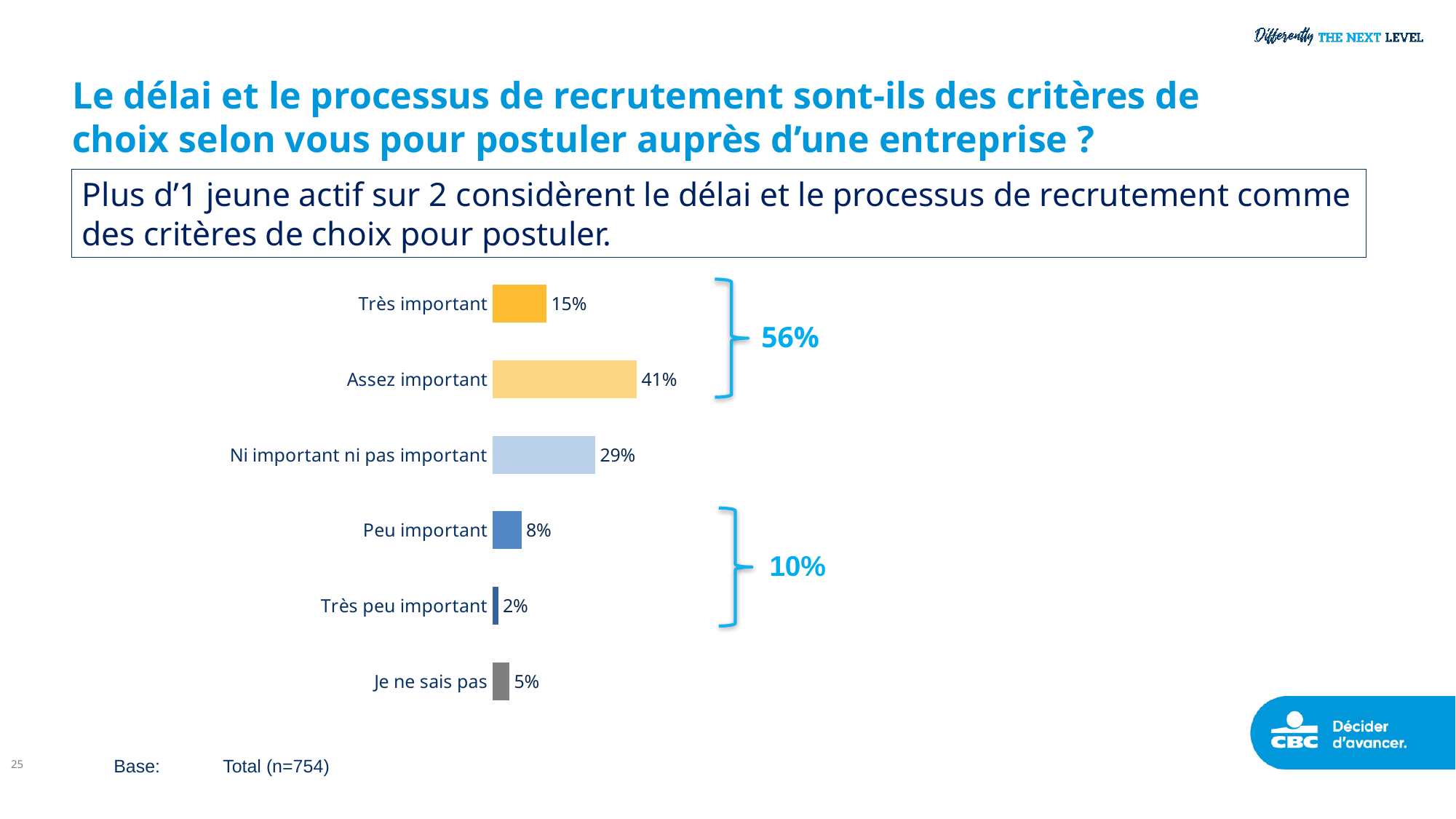
What is the value for "Très important"? 15% What is the difference between "Assez important" and "Très important"? 26% What combined percentage is shown by the bracket grouping "Très important" and "Assez important"? 56% Which category has the highest value? Assez important Which is larger, "Peu important" or "Je ne sais pas"? Peu important Which category has the lowest value? Très peu important What kind of chart is shown on the slide? Bar chart What is the value for "Je ne sais pas"? 5% What is the value for "Ni important ni pas important"? 29% What is the value for "Assez important"? 41% What combined percentage is shown by the bracket grouping "Peu important" and "Très peu important"? 10% How many categories are shown in the chart? 6